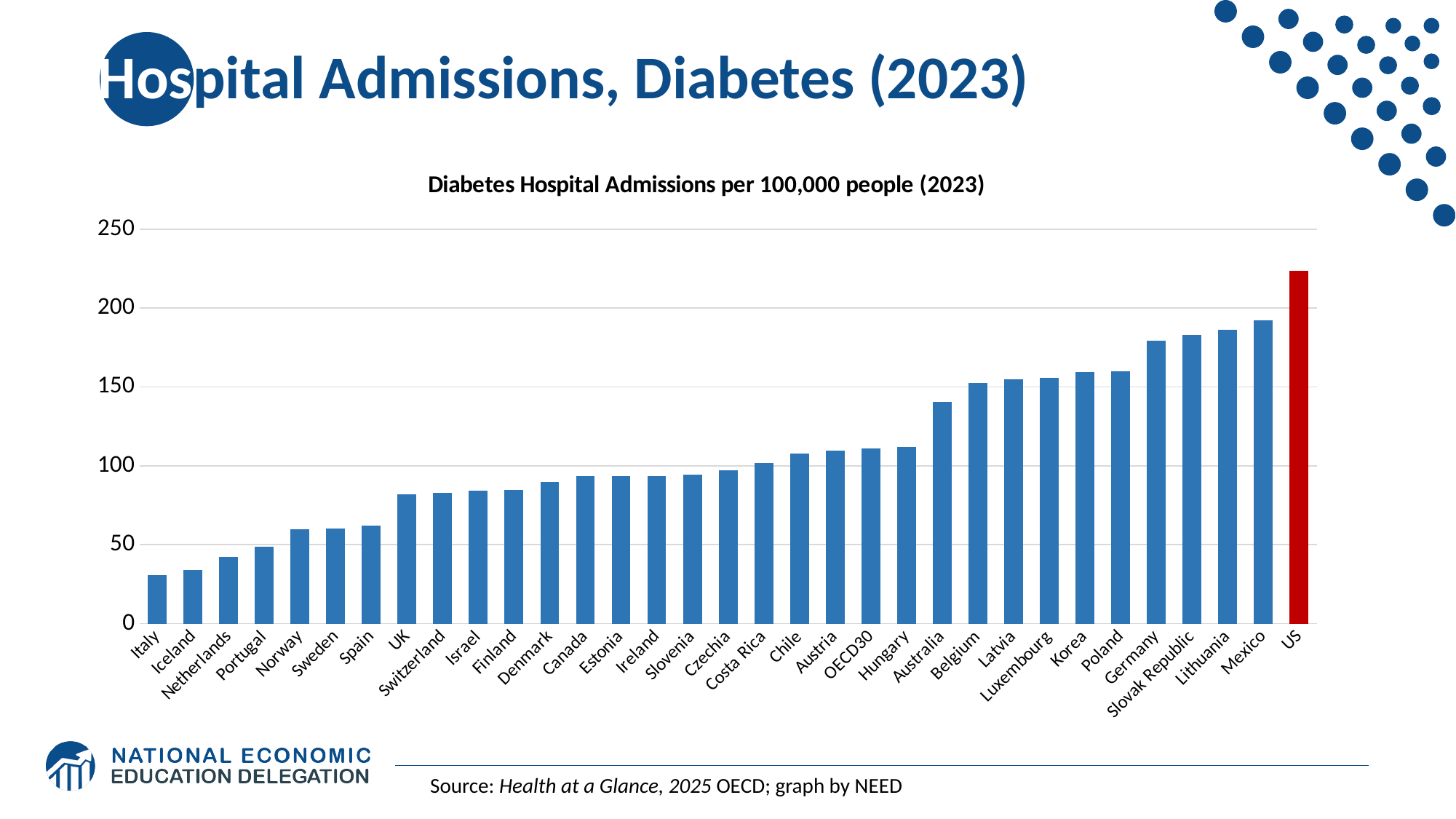
Is the value for the US greater or less than 200? greater Which bar is coloured red rather than blue? US Which has a higher value, the US or Mexico? US What kind of chart is shown on the slide? bar chart Which country has the lowest diabetes hospital admissions per 100,000 people? Italy Which country has the highest diabetes hospital admissions per 100,000 people? US How many bars (countries and groups) are plotted in the chart? 33 Is the value for Mexico greater or less than 200? less Is the value for Denmark greater or less than 100? less Do the values rise or fall moving from left to right along the x axis? rise